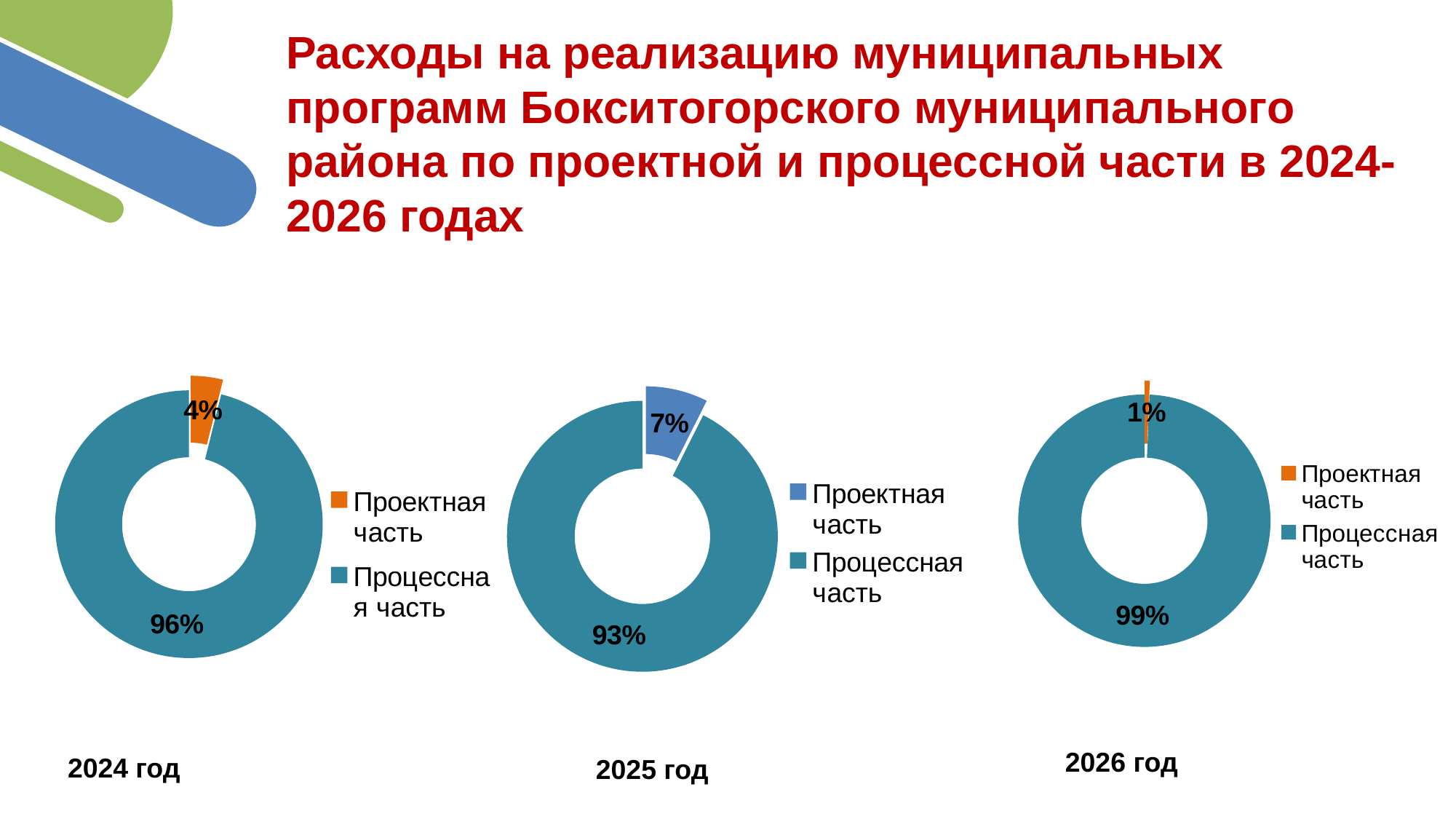
In the 2024 год chart, what share is labelled for Процессная часть? 96% How many charts are shown on the slide? 3 In the 2026 год chart, which category has the smallest share? Проектная часть In the 2026 год chart, what share is labelled for Процессная часть? 99% In the 2025 год chart, what share is labelled for Проектная часть? 7% In the 2024 год chart, what is the difference in percentage points between Процессная часть and Проектная часть? 92 Which year's chart shows the larger share for Проектная часть, 2024 год or 2025 год? 2025 год In the 2025 год chart, which category has the largest share? Процессная часть In the 2026 год chart, what share is labelled for Проектная часть? 1% What kind of chart is used for 2024 год? Doughnut (pie) chart In the 2025 год chart, what share is labelled for Процессная часть? 93% In the 2024 год chart, what share is labelled for Проектная часть? 4%